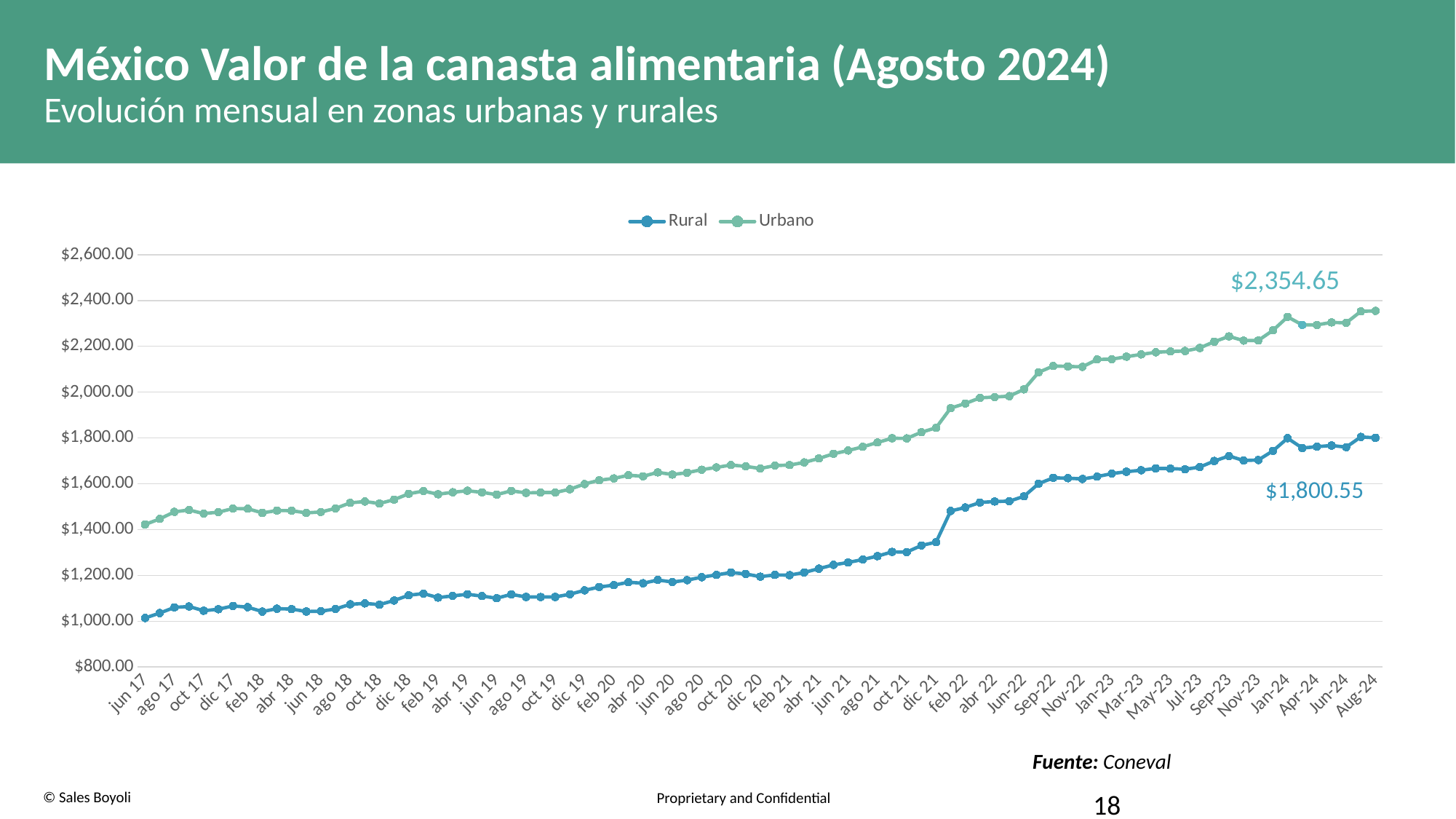
What is the labelled value of the Urbano series at Aug-24? $2,354.65 What are the two series names shown in the legend? Rural and Urbano What is the labelled value of the Rural series at Aug-24? $1,800.55 Is the value for the Rural series at jun 17 greater or less than $1,200.00? less What kind of chart is shown on the slide? line chart How many series does the legend list? 2 What is the difference between the Urbano and Rural values labelled at Aug-24? $554.10 Is the value for the Rural series at dic 21 greater or less than $1,400.00? less Do the values of the Urbano series generally rise or fall from jun 17 to Aug-24? rise Which series has the higher values across the whole period, Rural or Urbano? Urbano At Aug-24, which series has the larger value, Rural or Urbano? Urbano Is the value for the Urbano series at feb 22 greater or less than $1,800.00? greater